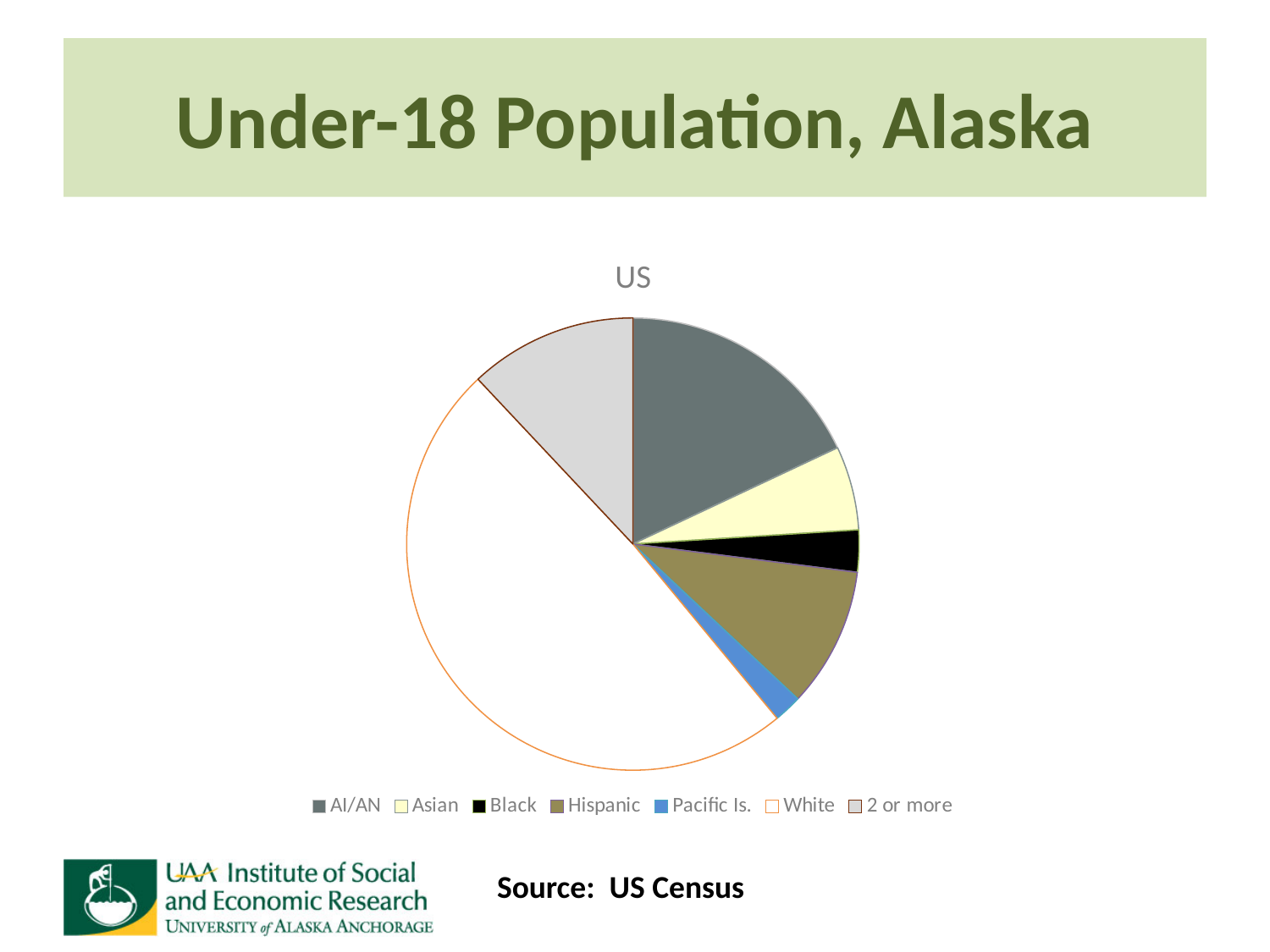
What is the source cited for the chart data? US Census What colour is the Pacific Is. slice in the pie chart? blue Which category has the largest slice of the pie chart? White Which slice is larger, Hispanic or Pacific Is.? Hispanic What is the title of the pie chart? US Which slice is larger, AI/AN or Asian? AI/AN How many categories does the legend of the pie chart list? 7 Which slice is larger, Hispanic or Black? Hispanic What kind of chart is shown on the slide? pie chart